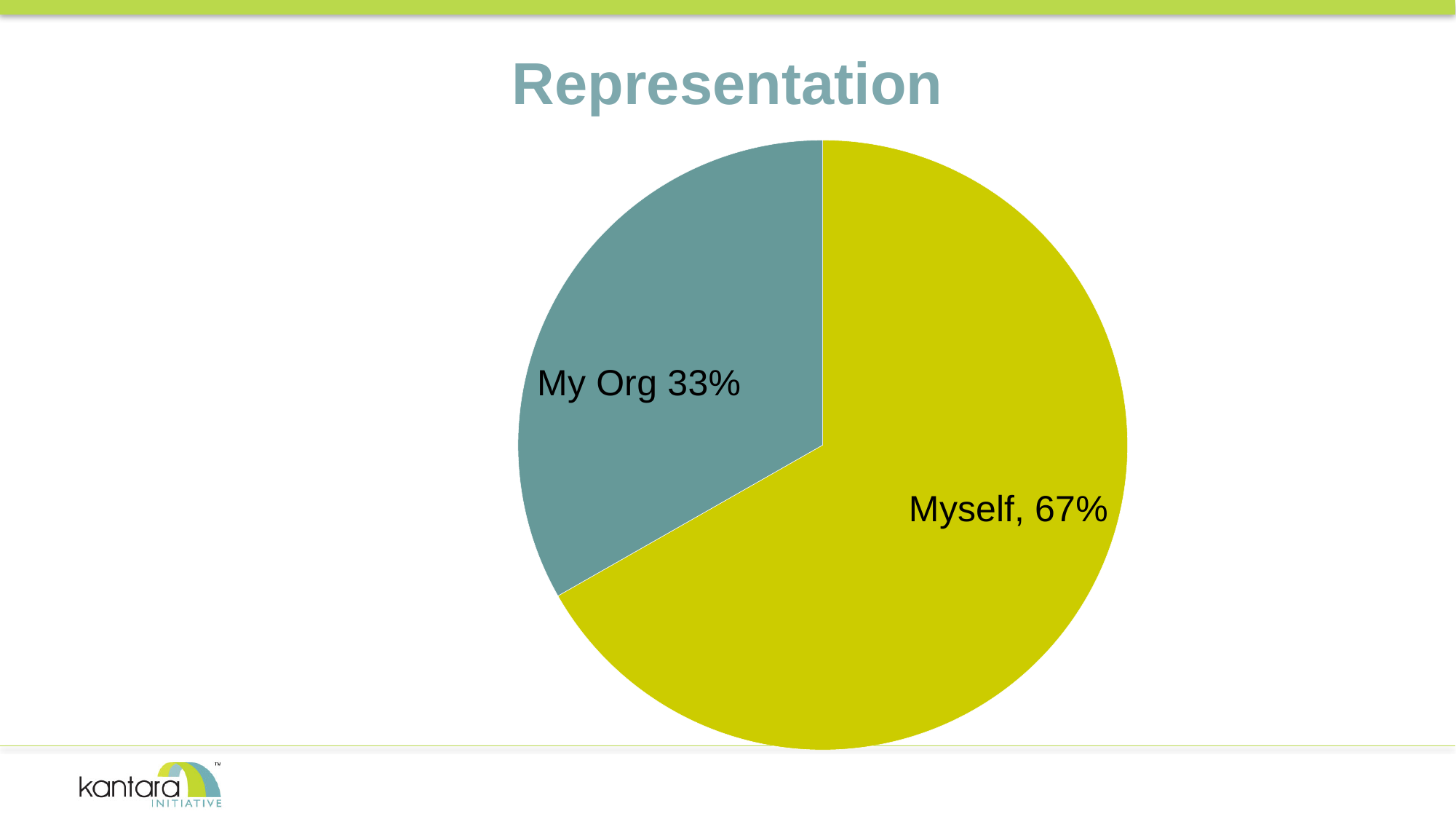
What is the difference in percentage points between the Myself slice and the My Org slice? 34 What share of the pie does the My Org slice represent? 33% What share of the pie does the Myself slice represent? 67% What kind of chart is shown on the slide? pie chart What is the title of the chart? Representation Which slice is the smallest? My Org Which is larger, the Myself slice or the My Org slice? Myself Which slice is the largest? Myself How many slices does the pie chart have? 2 Is the value for My Org greater or less than 50%? less What colour is the Myself slice? yellow-green